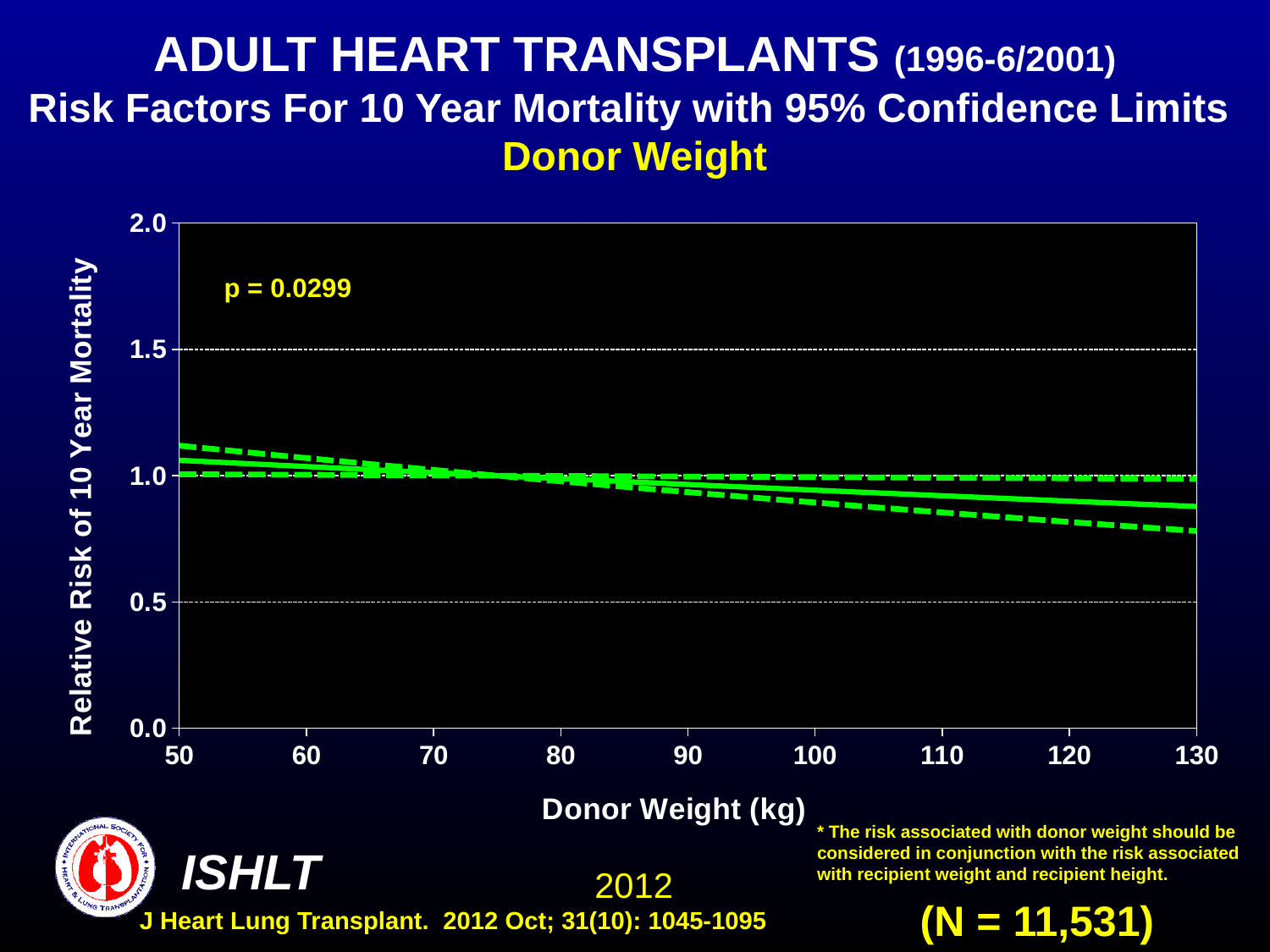
Is the relative risk of 10 year mortality at a donor weight of 130 kg greater or less than 0.5? greater What is the p-value shown on the chart? p = 0.0299 Is the relative risk of 10 year mortality at a donor weight of 130 kg greater or less than 1.0? less Is the lower 95% confidence limit at a donor weight of 130 kg greater or less than 0.5? greater What kind of chart is shown on the slide? line chart What is the label of the x axis? Donor Weight (kg) Does the relative risk of 10 year mortality rise or fall as donor weight increases from 50 kg to 130 kg? fall How many lines are plotted on the chart? 3 Is the relative risk of 10 year mortality higher at a donor weight of 50 kg or at 130 kg? 50 kg